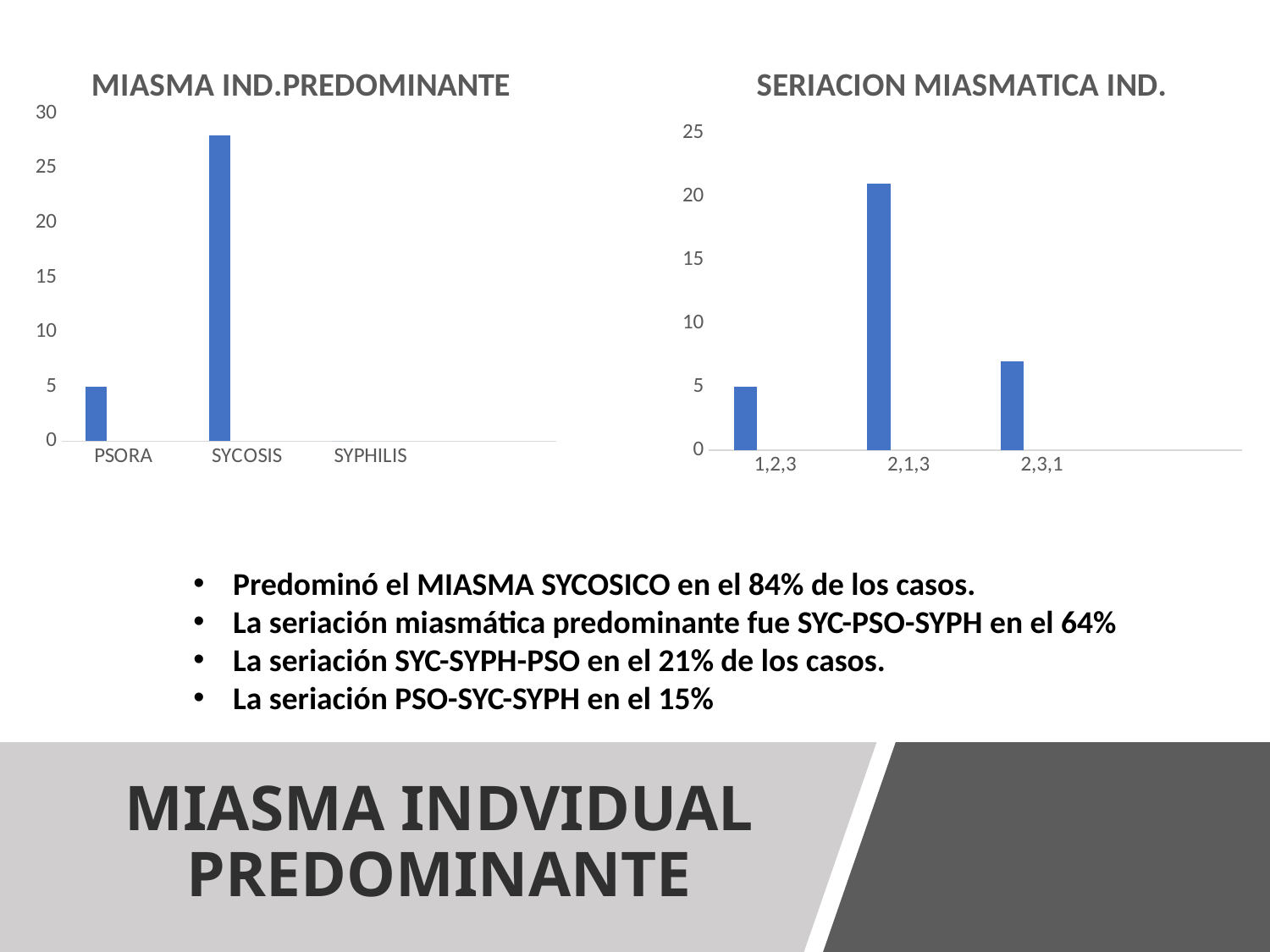
In the SERIACION MIASMATICA IND. chart, is the value for 2,3,1 greater or less than 10? less What kind of chart is the MIASMA IND.PREDOMINANTE chart? bar chart In the SERIACION MIASMATICA IND. chart, which category has the lowest value? 1,2,3 In the MIASMA IND.PREDOMINANTE chart, is the value for PSORA greater or less than 10? less In the MIASMA IND.PREDOMINANTE chart, how many categories are shown on the x axis? 3 In the MIASMA IND.PREDOMINANTE chart, which category has the lowest value? SYPHILIS In the SERIACION MIASMATICA IND. chart, which category has the highest value? 2,1,3 In the MIASMA IND.PREDOMINANTE chart, is the value for SYCOSIS greater or less than 25? greater In the SERIACION MIASMATICA IND. chart, which is larger, the value for 2,3,1 or the value for 1,2,3? 2,3,1 In the MIASMA IND.PREDOMINANTE chart, which category has the highest value? SYCOSIS What is the title of the chart on the right side of the slide? SERIACION MIASMATICA IND.